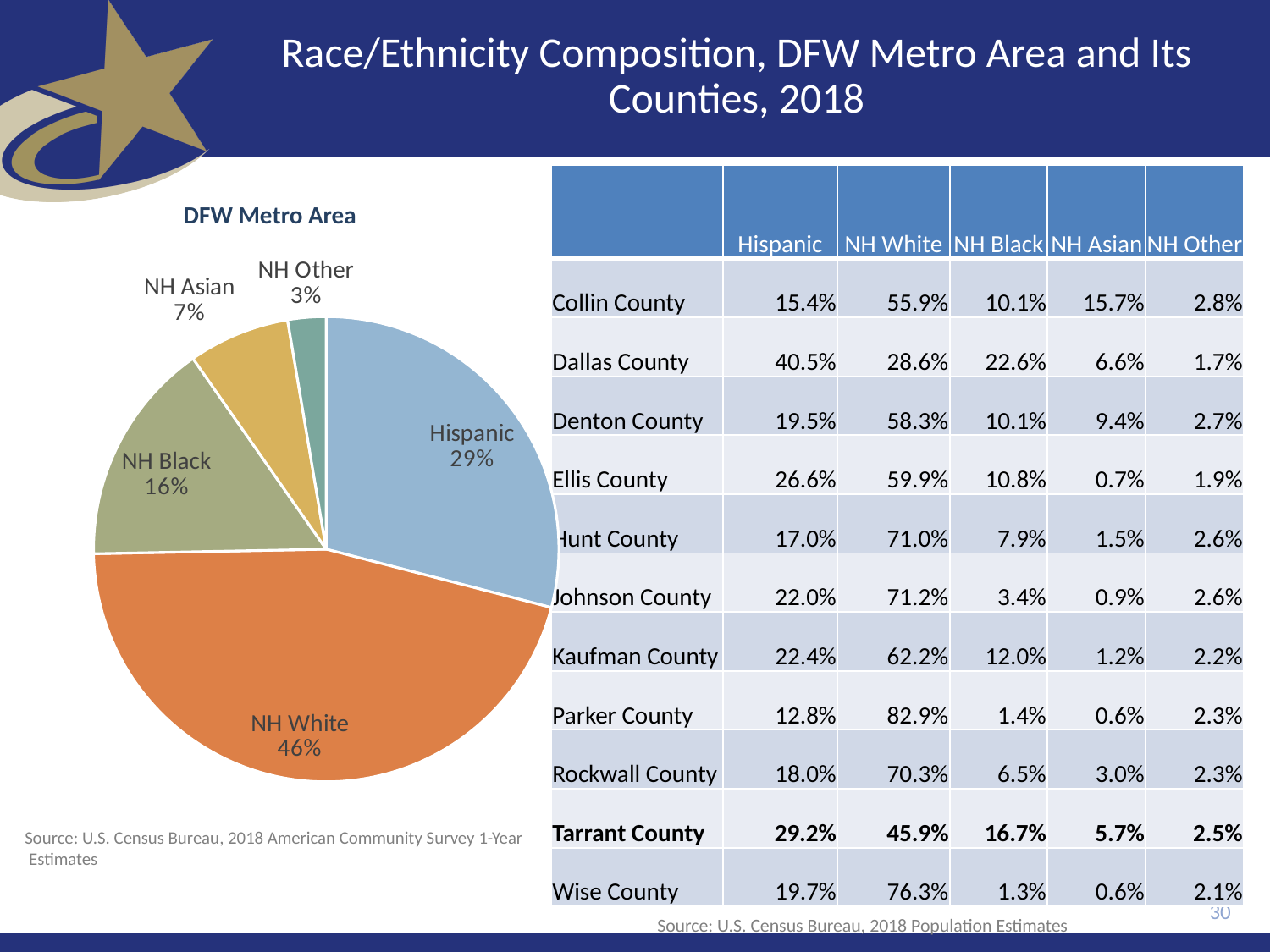
In the DFW Metro Area pie chart, what share does NH Other have? 3% Which slice is the largest in the DFW Metro Area pie chart? NH White In the DFW Metro Area pie chart, what is the difference between the NH White share and the Hispanic share? 17% What type of chart is shown under the title "DFW Metro Area"? pie chart In the DFW Metro Area pie chart, what share does NH White have? 46% In the DFW Metro Area pie chart, which is larger, NH Black or NH Asian? NH Black What is the title of the pie chart on the slide? DFW Metro Area Which slice is the smallest in the DFW Metro Area pie chart? NH Other In the DFW Metro Area pie chart, what share does NH Asian have? 7% In the DFW Metro Area pie chart, what share does NH Black have? 16% In the DFW Metro Area pie chart, what share does Hispanic have? 29% How many slices does the DFW Metro Area pie chart have? 5